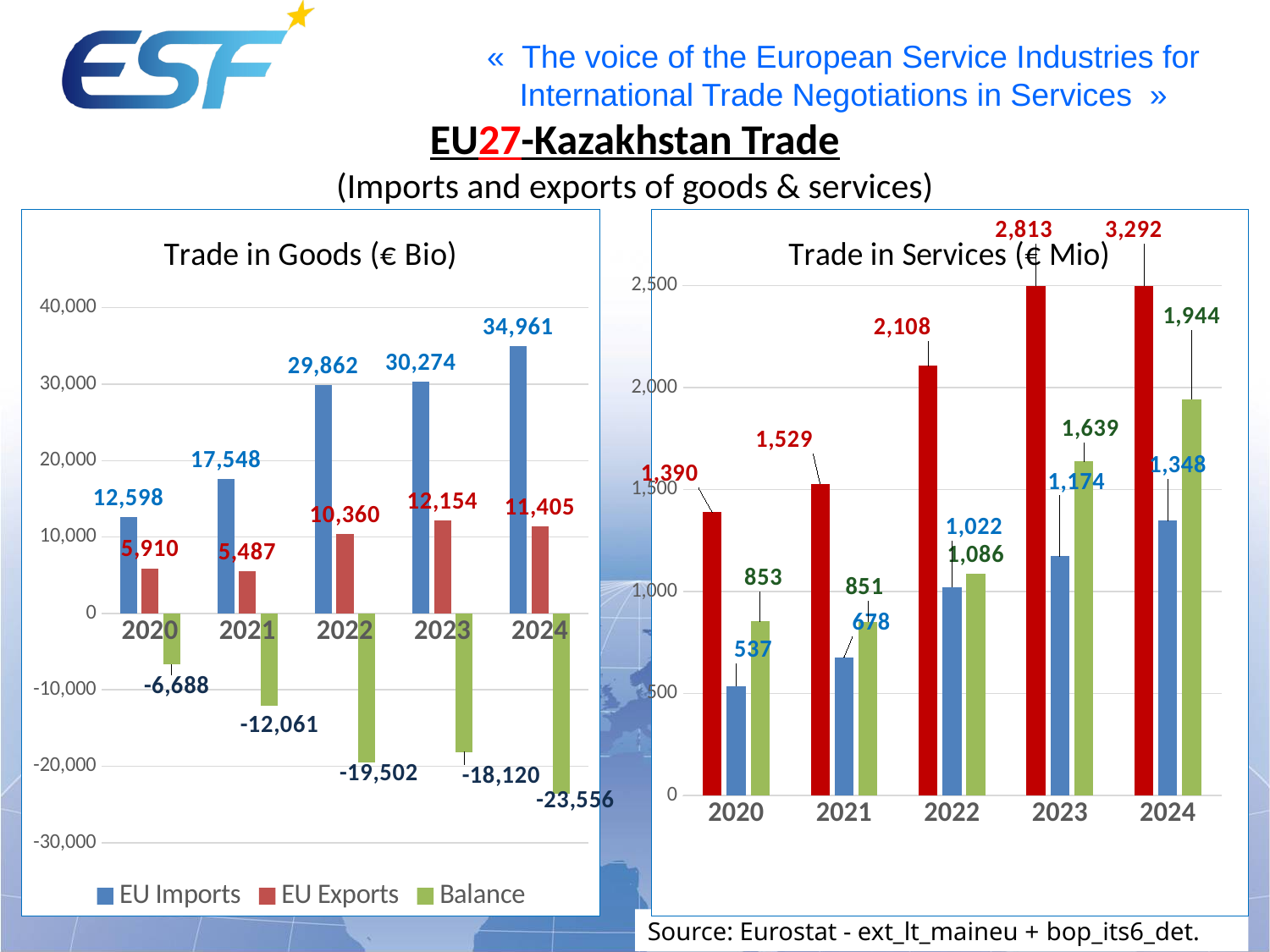
In the Trade in Services (€ Mio) chart, what is the value of the blue bar for 2020? 537 In the Trade in Services (€ Mio) chart, do the red bar values rise or fall from 2020 to 2024? rise In the Trade in Goods (€ Bio) chart, which year has the highest EU Imports value? 2024 In the Trade in Goods (€ Bio) chart, what is the value of EU Exports in 2022? 10,360 In the Trade in Services (€ Mio) chart, what is the value of the red bar for 2024? 3,292 In the Trade in Goods (€ Bio) chart, how many series does the legend list? 3 In the Trade in Goods (€ Bio) chart, which year has the lowest EU Exports value? 2021 In the Trade in Goods (€ Bio) chart, what is the Balance value for 2021? -12,061 In the Trade in Goods (€ Bio) chart, what is the difference between EU Imports and EU Exports in 2023? 18,120 What kind of chart is the Trade in Services (€ Mio) chart? bar chart In the Trade in Goods (€ Bio) chart, what is the value of EU Imports in 2024? 34,961 In the Trade in Services (€ Mio) chart, is the value of the green bar for 2023 greater or less than 1,500? greater